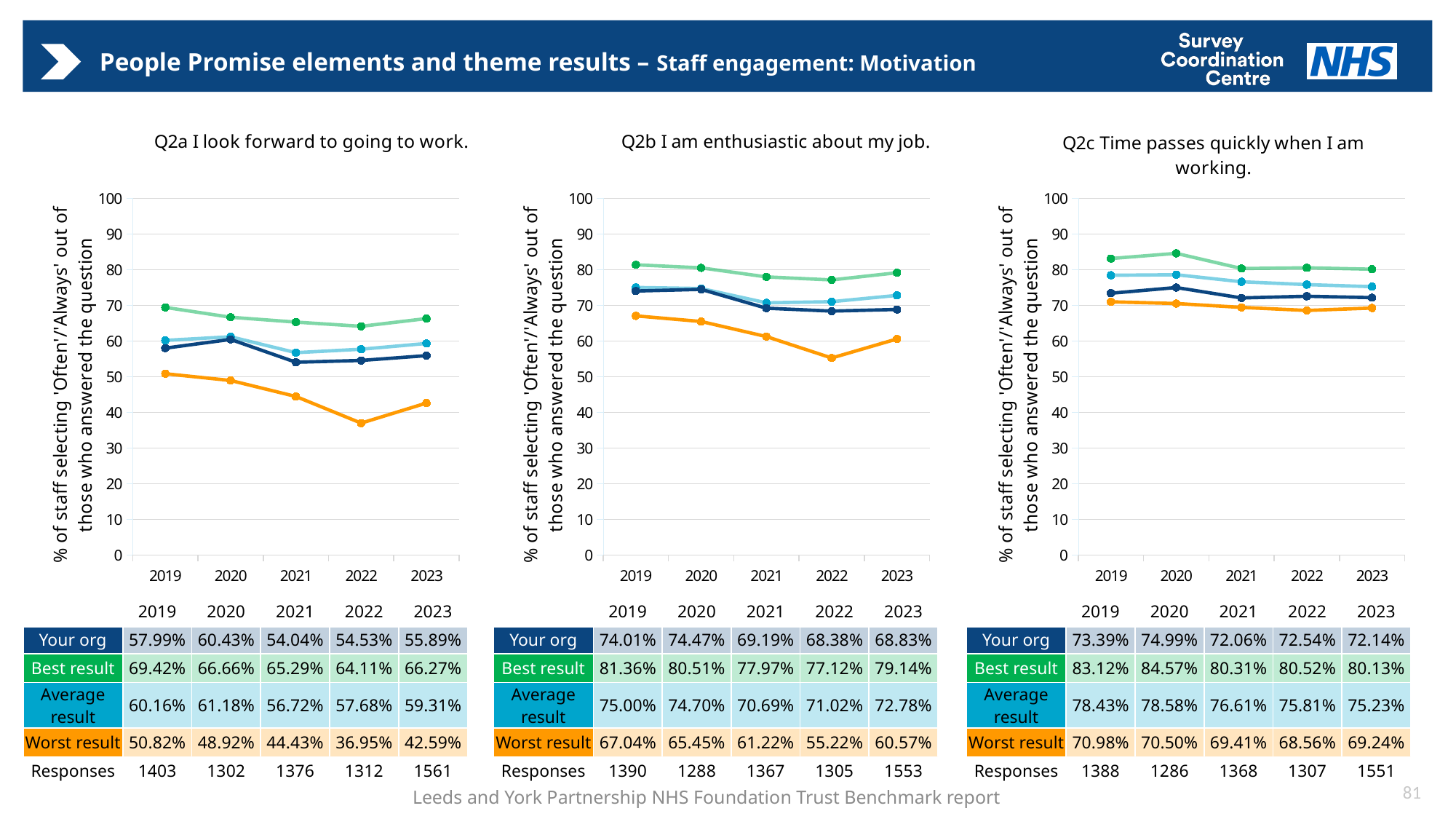
In the Q2a chart, in which year is the Worst result line at its lowest? 2022 In the Q2a chart, which is larger in 2020: the Your org value or the Average result value? Average result In the Q2c chart, in which year is the Best result line at its highest? 2020 In the Q2c 'Time passes quickly when I am working' chart, what is the Best result value for 2020? 84.57% How many lines are plotted in the Q2c chart? 4 In the Q2a chart, is the Worst result value for 2022 greater or less than 40? less In the Q2b chart, what is the difference between the Best result and Your org values in 2019? 7.35 percentage points In the Q2a 'I look forward to going to work' chart, what is the Your org value for 2023? 55.89% How many years are plotted on the x axis of the Q2a chart? 5 In the Q2b chart, does the Worst result line rise or fall from 2019 to 2022? Fall In the Q2b 'I am enthusiastic about my job' chart, what is the Worst result value for 2022? 55.22% What type of chart is used for Q2b 'I am enthusiastic about my job'? Line chart